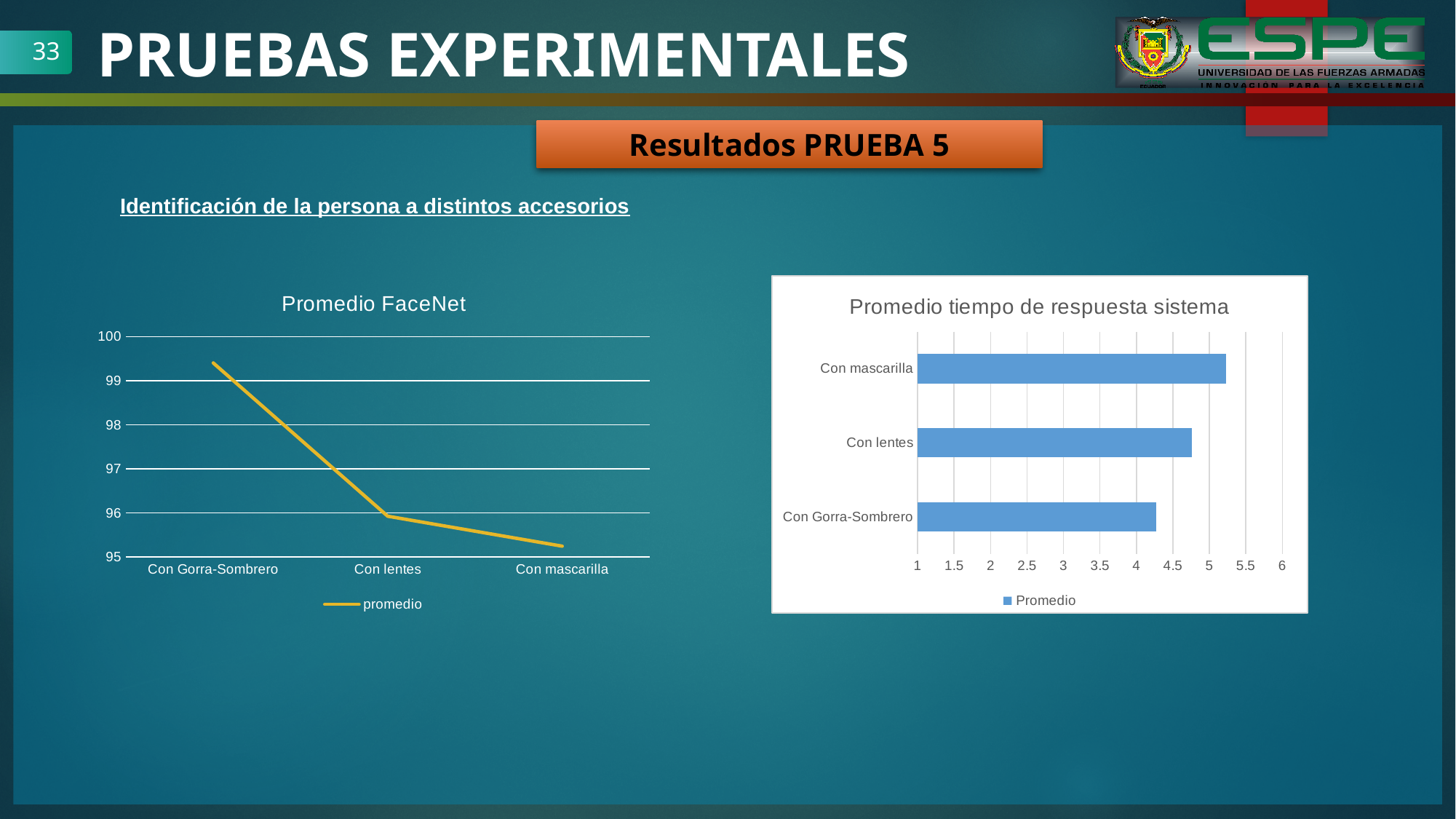
In the "Promedio tiempo de respuesta sistema" chart, which category has the shortest bar? Con Gorra-Sombrero In the "Promedio FaceNet" chart, which category has the lowest value? Con mascarilla In the "Promedio tiempo de respuesta sistema" chart, how many bars are there? 3 In the "Promedio FaceNet" chart, do the values rise or fall from Con Gorra-Sombrero to Con mascarilla? fall In the "Promedio FaceNet" chart, is the value for Con Gorra-Sombrero greater or less than 99? greater What kind of chart is the "Promedio FaceNet" chart? line chart What is the legend entry of the "Promedio tiempo de respuesta sistema" chart? Promedio What kind of chart is the "Promedio tiempo de respuesta sistema" chart? bar chart In the "Promedio tiempo de respuesta sistema" chart, is the value for Con mascarilla greater or less than 5? greater In the "Promedio FaceNet" chart, which category has the highest value? Con Gorra-Sombrero In the "Promedio tiempo de respuesta sistema" chart, which category has the longest bar? Con mascarilla In the "Promedio FaceNet" chart, how many categories are shown on the x axis? 3